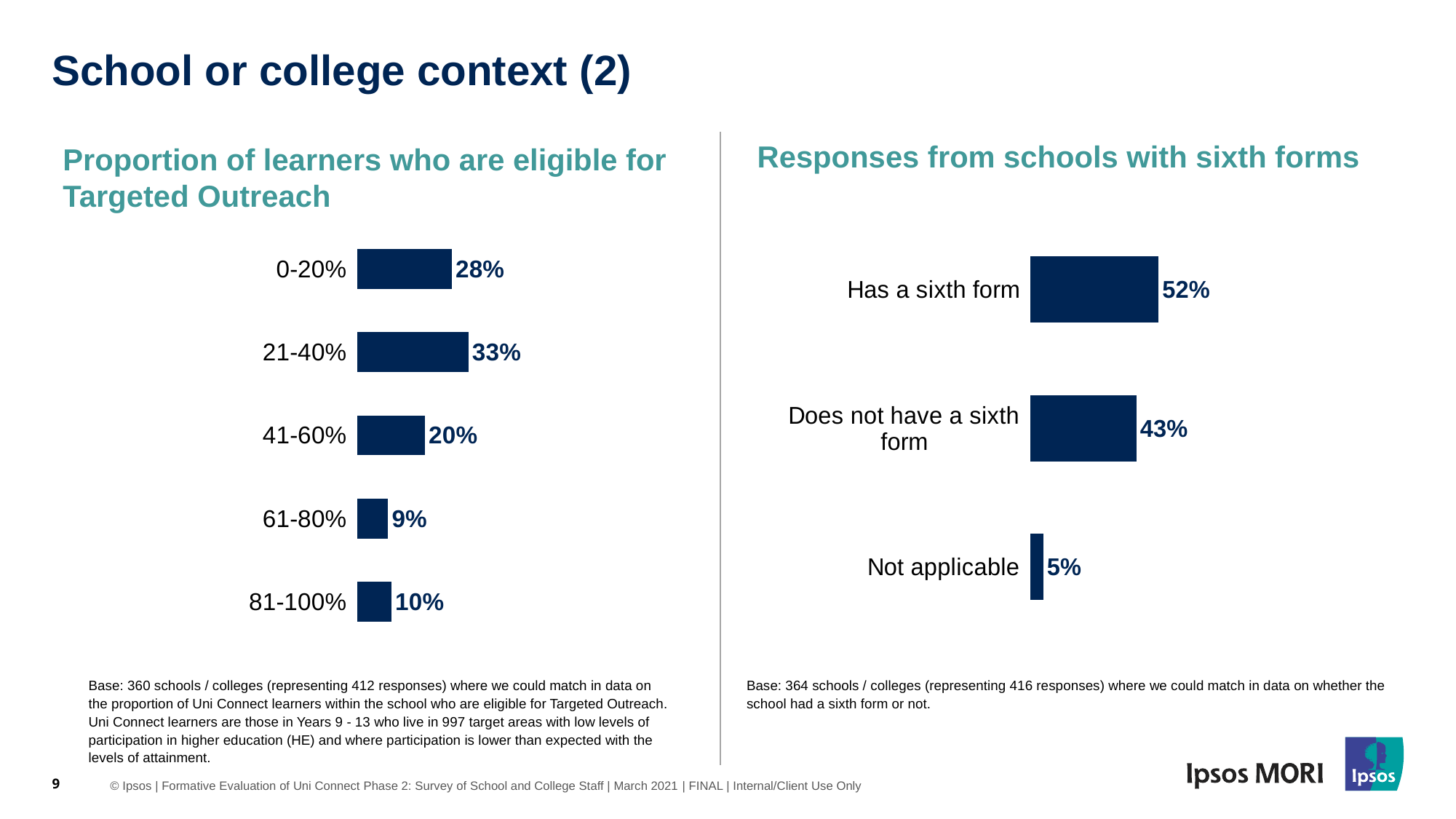
In the 'Proportion of learners who are eligible for Targeted Outreach' chart, which category has the highest value? 21-40% In the 'Proportion of learners who are eligible for Targeted Outreach' chart, how many categories are shown? 5 In the 'Responses from schools with sixth forms' chart, which is larger: 'Has a sixth form' or 'Does not have a sixth form'? Has a sixth form In the 'Responses from schools with sixth forms' chart, how many categories are shown? 3 In the 'Responses from schools with sixth forms' chart, what is the difference between 'Has a sixth form' and 'Does not have a sixth form'? 9 percentage points In the 'Responses from schools with sixth forms' chart, what is the value for 'Has a sixth form'? 52% In the 'Proportion of learners who are eligible for Targeted Outreach' chart, what is the difference between the values for 0-20% and 41-60%? 8 percentage points In the 'Proportion of learners who are eligible for Targeted Outreach' chart, what is the value for 61-80%? 9% In the 'Proportion of learners who are eligible for Targeted Outreach' chart, what is the value for 21-40%? 33% In the 'Proportion of learners who are eligible for Targeted Outreach' chart, which category has the lowest value? 61-80% What kind of chart is the 'Responses from schools with sixth forms' chart? Bar chart In the 'Responses from schools with sixth forms' chart, what is the value for 'Not applicable'? 5%